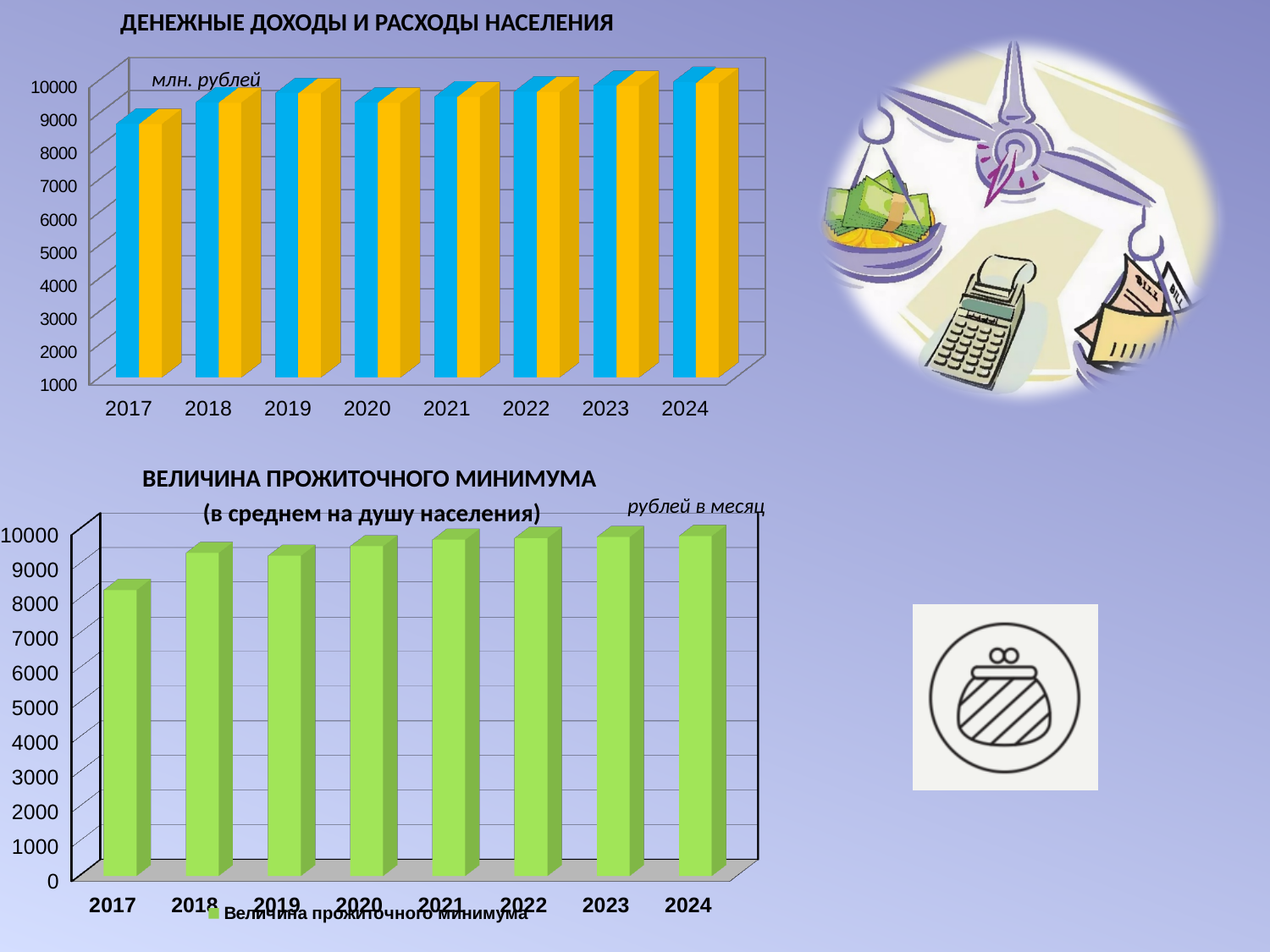
In the top chart "ДЕНЕЖНЫЕ ДОХОДЫ И РАСХОДЫ НАСЕЛЕНИЯ", is the value of the blue bar for 2017 greater or less than 9000? less In the top chart "ДЕНЕЖНЫЕ ДОХОДЫ И РАСХОДЫ НАСЕЛЕНИЯ", is the value of the yellow bar for 2024 greater or less than 9000? greater In the top chart "ДЕНЕЖНЫЕ ДОХОДЫ И РАСХОДЫ НАСЕЛЕНИЯ", which year has the larger blue bar, 2017 or 2024? 2024 What kind of chart is the bottom chart titled "ВЕЛИЧИНА ПРОЖИТОЧНОГО МИНИМУМА"? bar chart In the bottom chart "ВЕЛИЧИНА ПРОЖИТОЧНОГО МИНИМУМА", is the value for 2017 greater or less than 9000? less What unit is indicated on the top chart "ДЕНЕЖНЫЕ ДОХОДЫ И РАСХОДЫ НАСЕЛЕНИЯ"? млн. рублей How many series does the legend of the bottom chart "ВЕЛИЧИНА ПРОЖИТОЧНОГО МИНИМУМА" list? 1 What kind of chart is the top chart titled "ДЕНЕЖНЫЕ ДОХОДЫ И РАСХОДЫ НАСЕЛЕНИЯ"? bar chart In the top chart "ДЕНЕЖНЫЕ ДОХОДЫ И РАСХОДЫ НАСЕЛЕНИЯ", which year has the lowest bars? 2017 In the top chart "ДЕНЕЖНЫЕ ДОХОДЫ И РАСХОДЫ НАСЕЛЕНИЯ", how many years are shown on the x axis? 8 In the bottom chart "ВЕЛИЧИНА ПРОЖИТОЧНОГО МИНИМУМА", which year has the lowest value? 2017